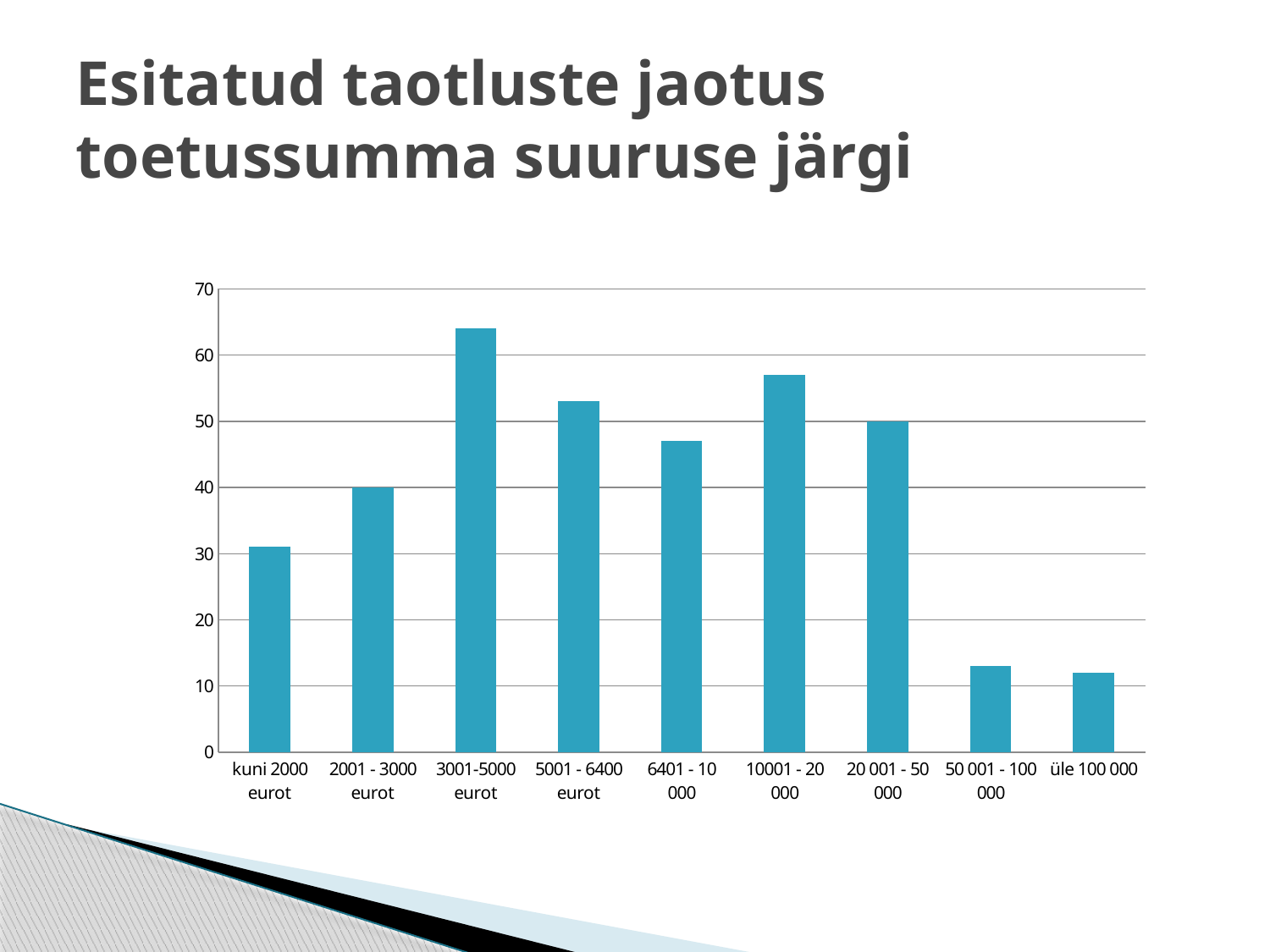
What is the value for the category 2001 - 3000 eurot? 40 Is the value for 6401 - 10 000 greater or less than 50? less What is the value for the category 20 001 - 50 000? 50 Is the value for 3001-5000 eurot greater or less than 60? greater Is the value for kuni 2000 eurot greater or less than 40? less What is the title of the slide containing the chart? Esitatud taotluste jaotus toetussumma suuruse järgi Which is larger, the value for 3001-5000 eurot or the value for 10001 - 20 000? 3001-5000 eurot How many categories are shown on the x axis of the chart? 9 What kind of chart is shown on the slide? bar chart Which category has the highest bar in the chart? 3001-5000 eurot